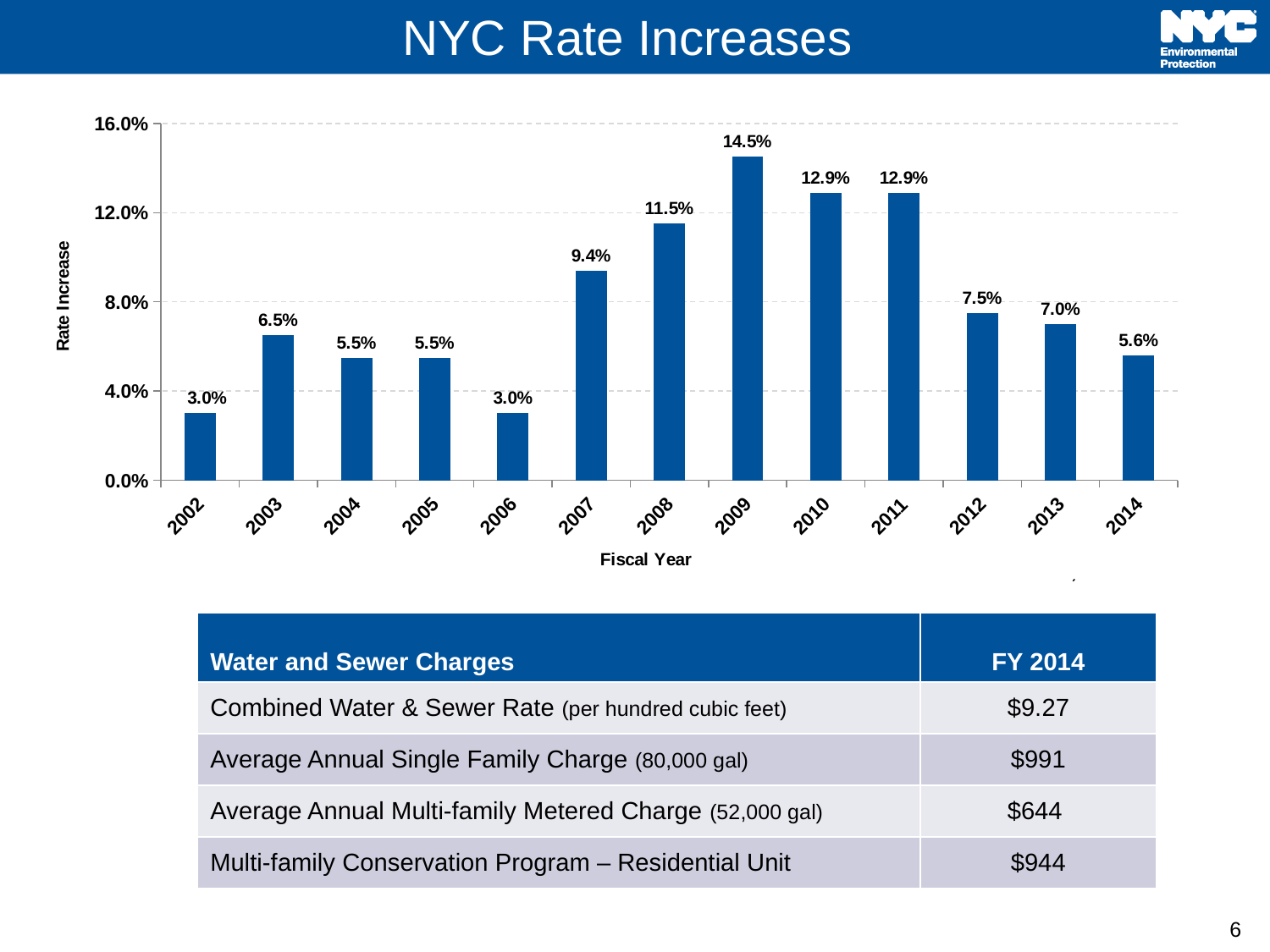
What kind of chart is shown on the slide? bar chart What is the rate increase for fiscal year 2014? 5.6% What is the rate increase for fiscal year 2007? 9.4% Which fiscal year has the highest rate increase? 2009 Do the rate increases rise or fall from 2011 to 2014? fall What is the difference between the rate increase in 2012 and the rate increase in 2013? 0.5% Is the rate increase for 2010 greater or less than 12.0%? greater Which is larger, the rate increase in 2003 or the rate increase in 2004? 2003 How many fiscal years are shown on the x axis of the chart? 13 What is the rate increase for fiscal year 2009? 14.5% What is the label of the y axis of the chart? Rate Increase What is the difference between the rate increase in 2009 and the rate increase in 2008? 3.0%